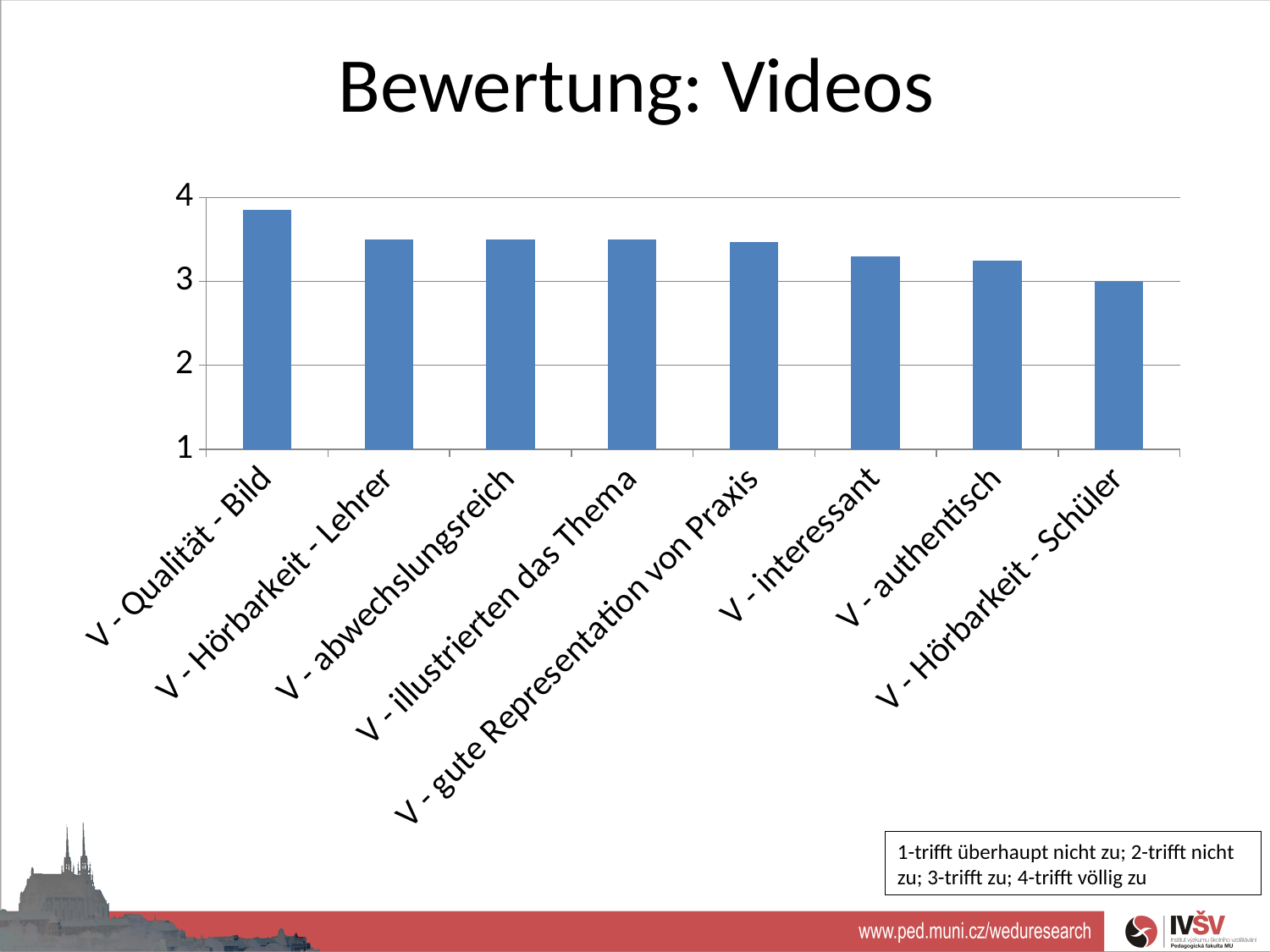
What is the highest value shown on the vertical axis? 4 Is the value for V - authentisch greater or less than 3? greater What is the title of the chart? Bewertung: Videos Which category has the lowest value? V - Hörbarkeit - Schüler Is the value for V - interessant greater or less than 4? less Which category has the highest value? V - Qualität - Bild What type of chart is shown on the slide? bar chart Is the value for V - Hörbarkeit - Schüler greater or less than 2? greater Which is larger, the value for V - Qualität - Bild or the value for V - interessant? V - Qualität - Bild How many categories are plotted in the chart? 8 Do the values rise or fall from left to right along the x axis? fall